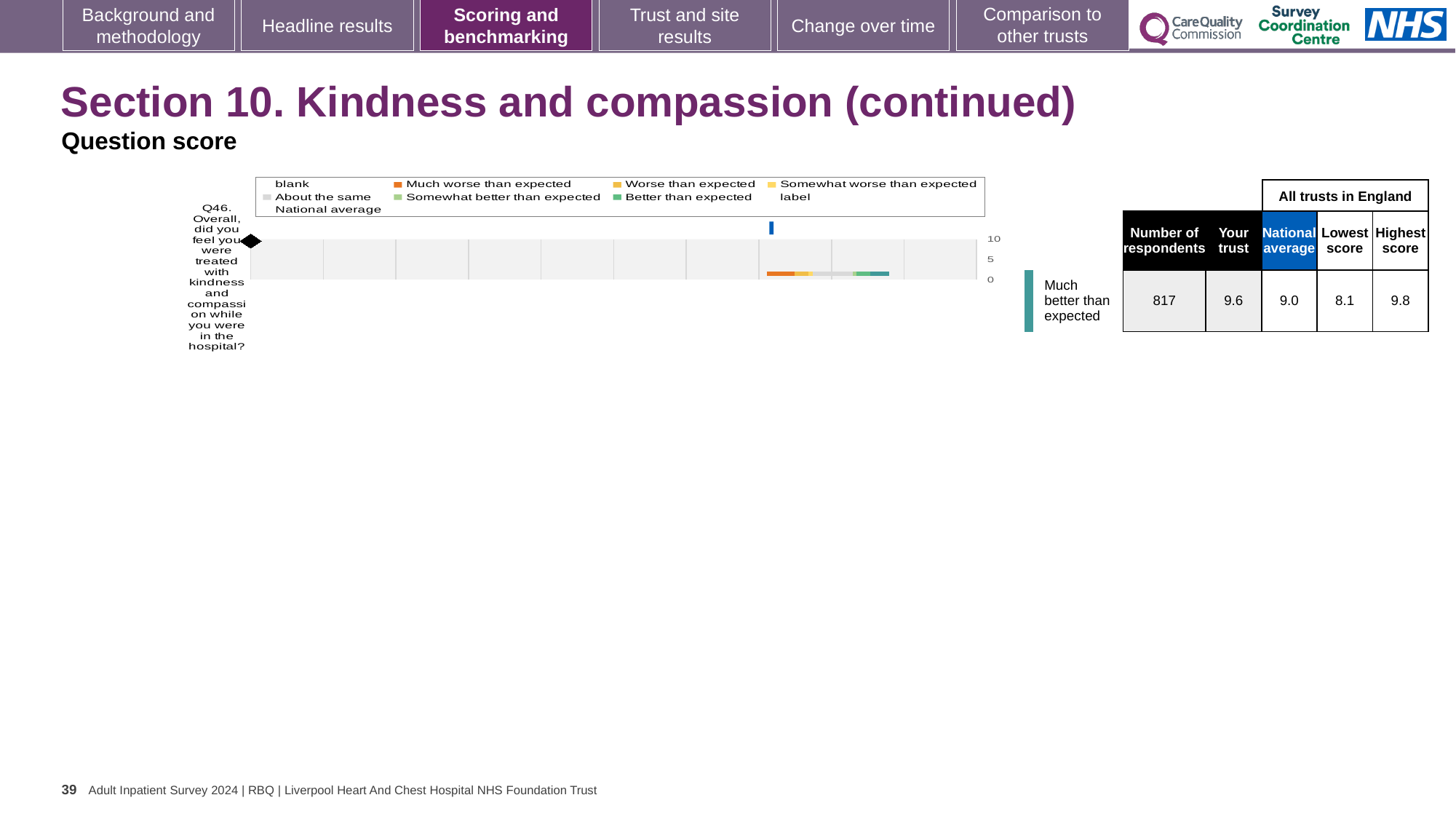
Which question is plotted on the chart? Q46. Overall, did you feel you were treated with kindness and compassion while you were in the hospital? How many questions (categories) are plotted on the chart? 1 What is the lowest score among all trusts in England for Q46? 8.1 What is the difference between the highest and lowest scores among all trusts in England for Q46? 1.7 What is the national average score for Q46? 9.0 What is the difference between the 'Your trust' score and the national average for Q46? 0.6 Which is larger for Q46, the 'Your trust' score or the national average? Your trust How many respondents answered Q46? 817 What kind of chart is shown on the slide? bar chart What is the maximum value shown on the chart's score axis? 10 What is the 'Your trust' score for Q46? 9.6 What is the highest score among all trusts in England for Q46? 9.8